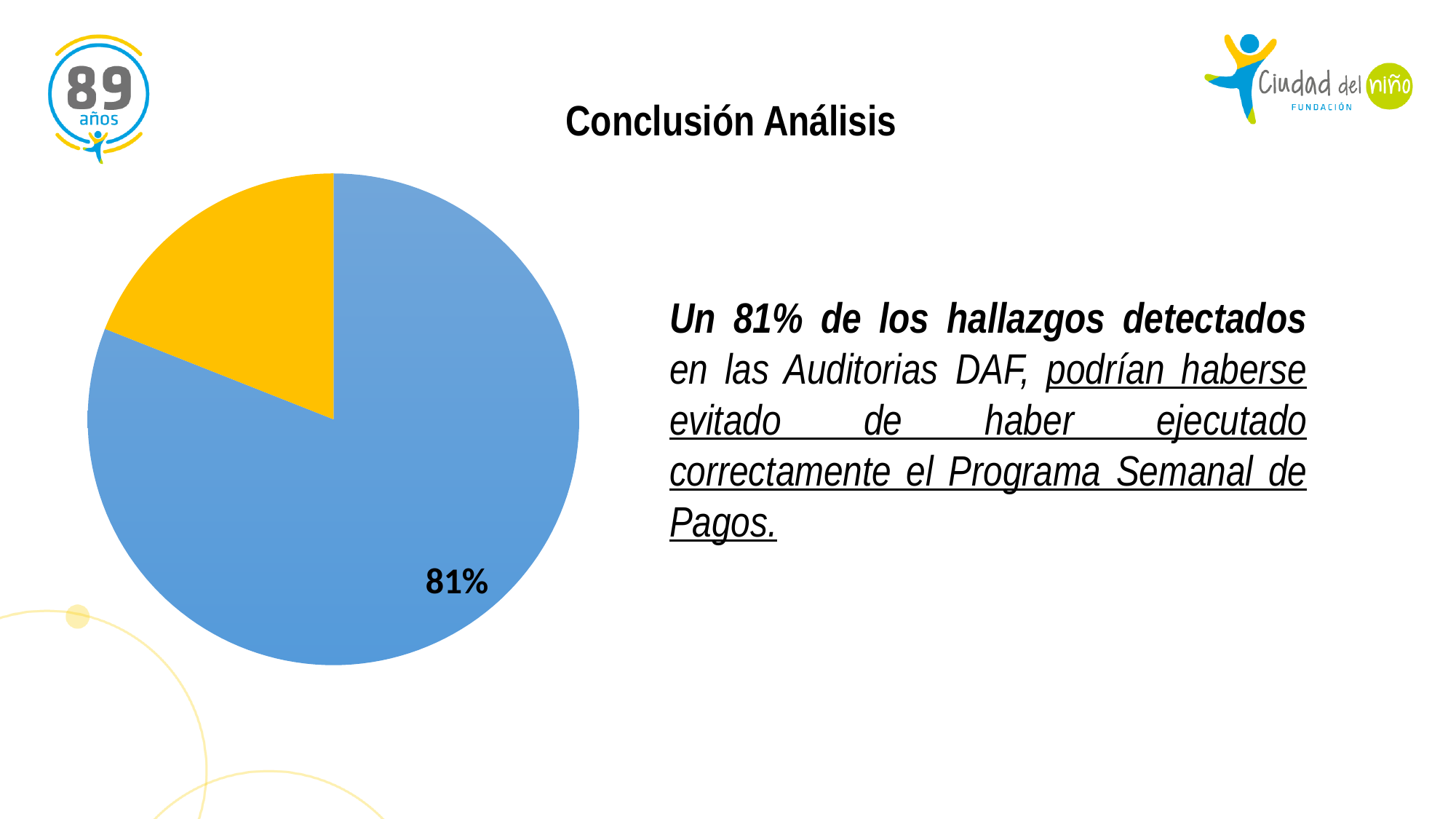
What percentage is printed on the blue slice of the pie chart? 81% Which slice of the pie chart is the smallest, the blue one or the yellow one? yellow What colour is the slice of the pie chart that carries the 81% label? blue What kind of chart is shown on the slide? pie chart How many slices does the pie chart have? 2 Which slice of the pie chart is the largest, the blue one or the yellow one? blue What is the title shown at the top of the slide above the pie chart? Conclusión Análisis Is the blue slice or the yellow slice of the pie chart larger? blue